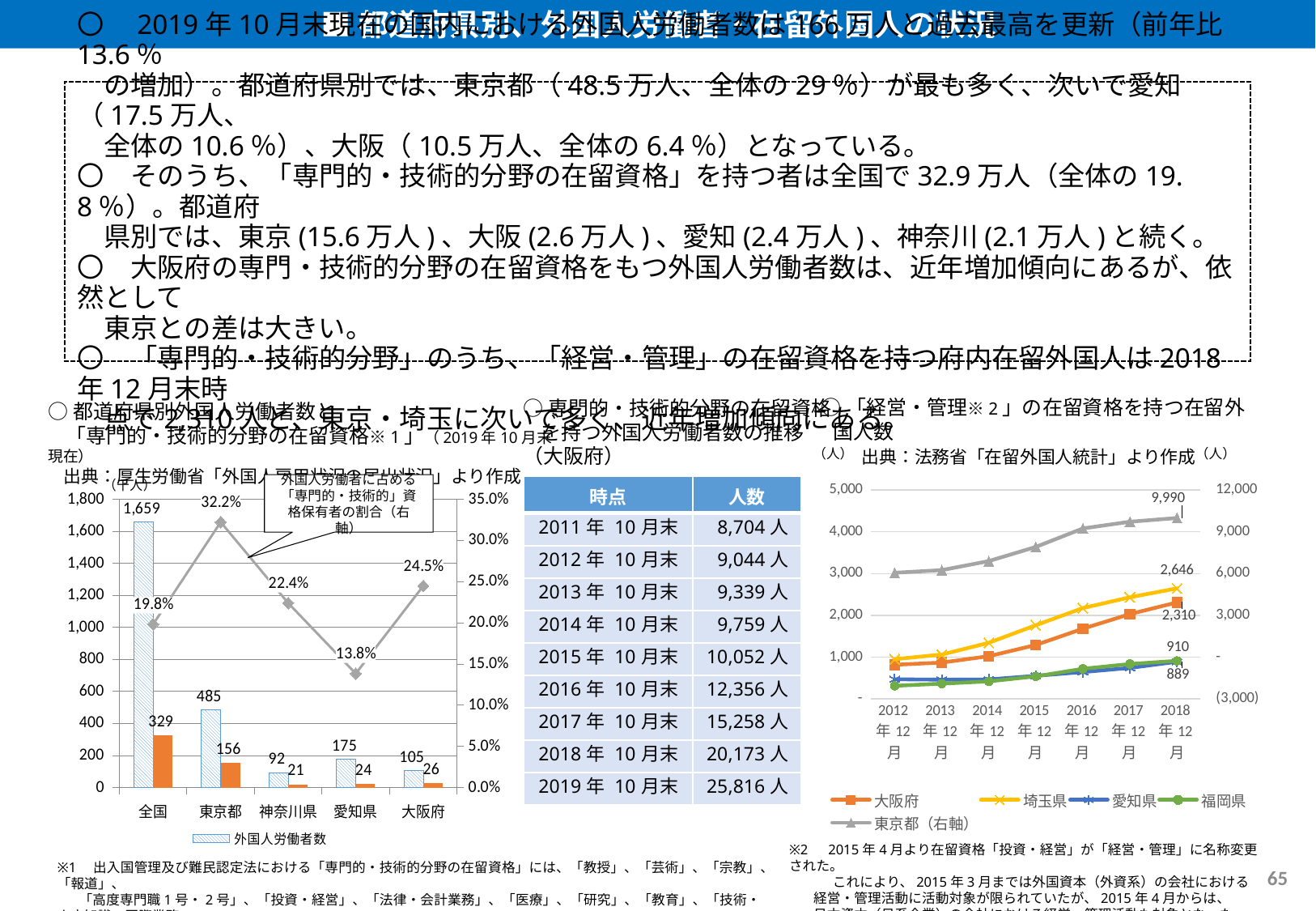
In the left chart, what is the difference between the orange bar values for 東京都 (156) and 大阪府 (26)? 130 In the left chart, what percentage is shown on the line for 東京都? 32.2% How many categories are shown on the x axis of the left chart? 5 In the right chart (「経営・管理」の在留資格を持つ在留外国人数), what is the value for 東京都 in 2018年12月? 9,990 In the left chart, what is the 外国人労働者数 value for 全国? 1,659 How many series does the legend of the right chart list? 5 In the left chart, which prefecture has the lowest percentage on the line? 愛知県 In the left chart (都道府県別外国人労働者数), what is the 外国人労働者数 value for 東京都? 485 In the left chart, what is the 外国人労働者数 value for 神奈川県? 92 In the right chart, does the 大阪府 line rise or fall from 2012 to 2018? rise In the right chart, which is larger in 2018年12月: 埼玉県 or 大阪府? 埼玉県 How many time points are shown on the x axis of the right chart? 7